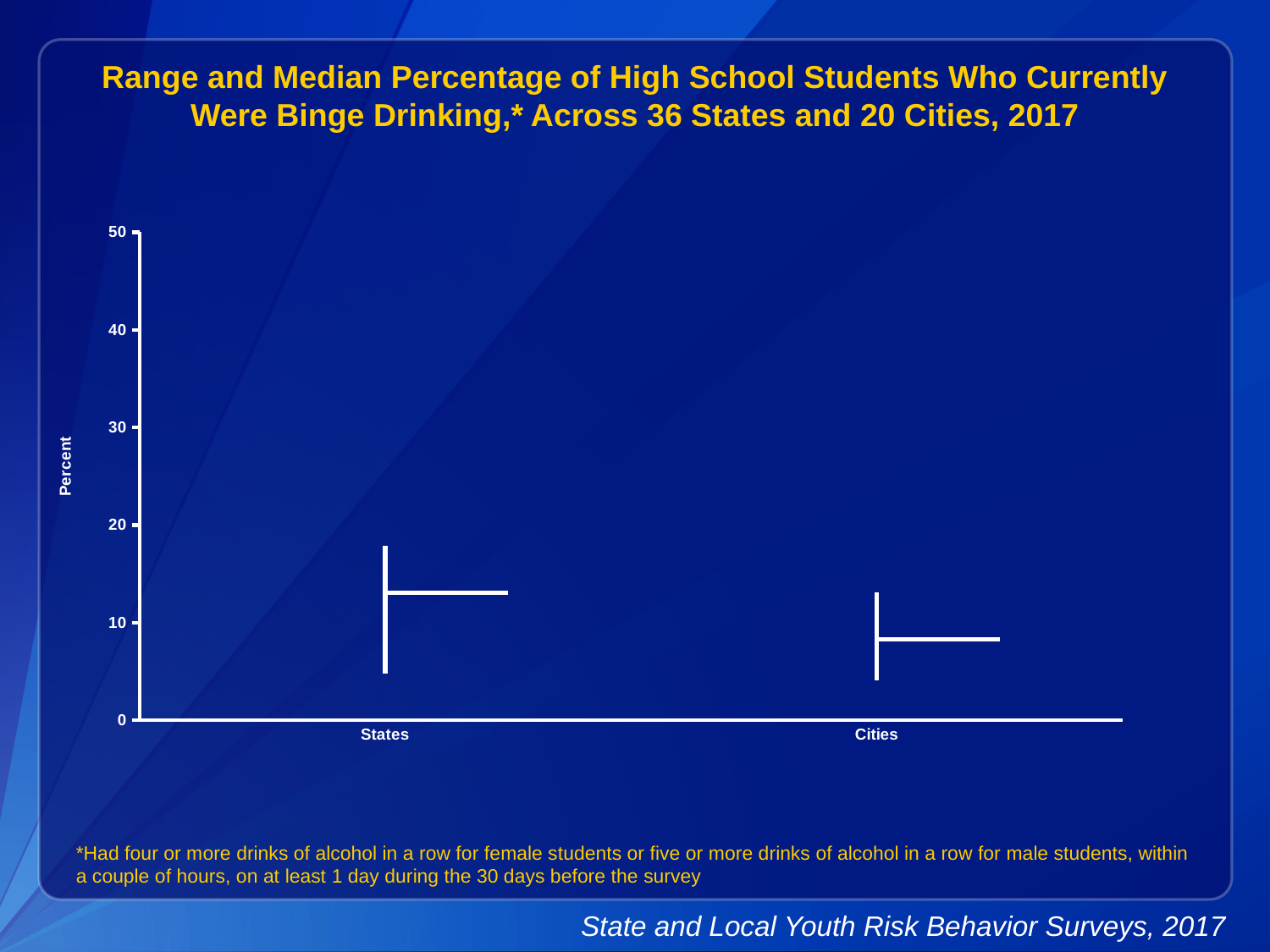
Which has the higher median percentage, States or Cities? States Which has the higher top of its range, States or Cities? States Is the median value for Cities greater or less than 10? less Is the bottom of the range for States greater or less than 10? less Is the bottom of the range for Cities greater or less than 10? less Which category has the lowest median percentage? Cities What is the label of the y axis? Percent What is the highest value shown on the y axis? 50 How many categories are shown on the x axis? 2